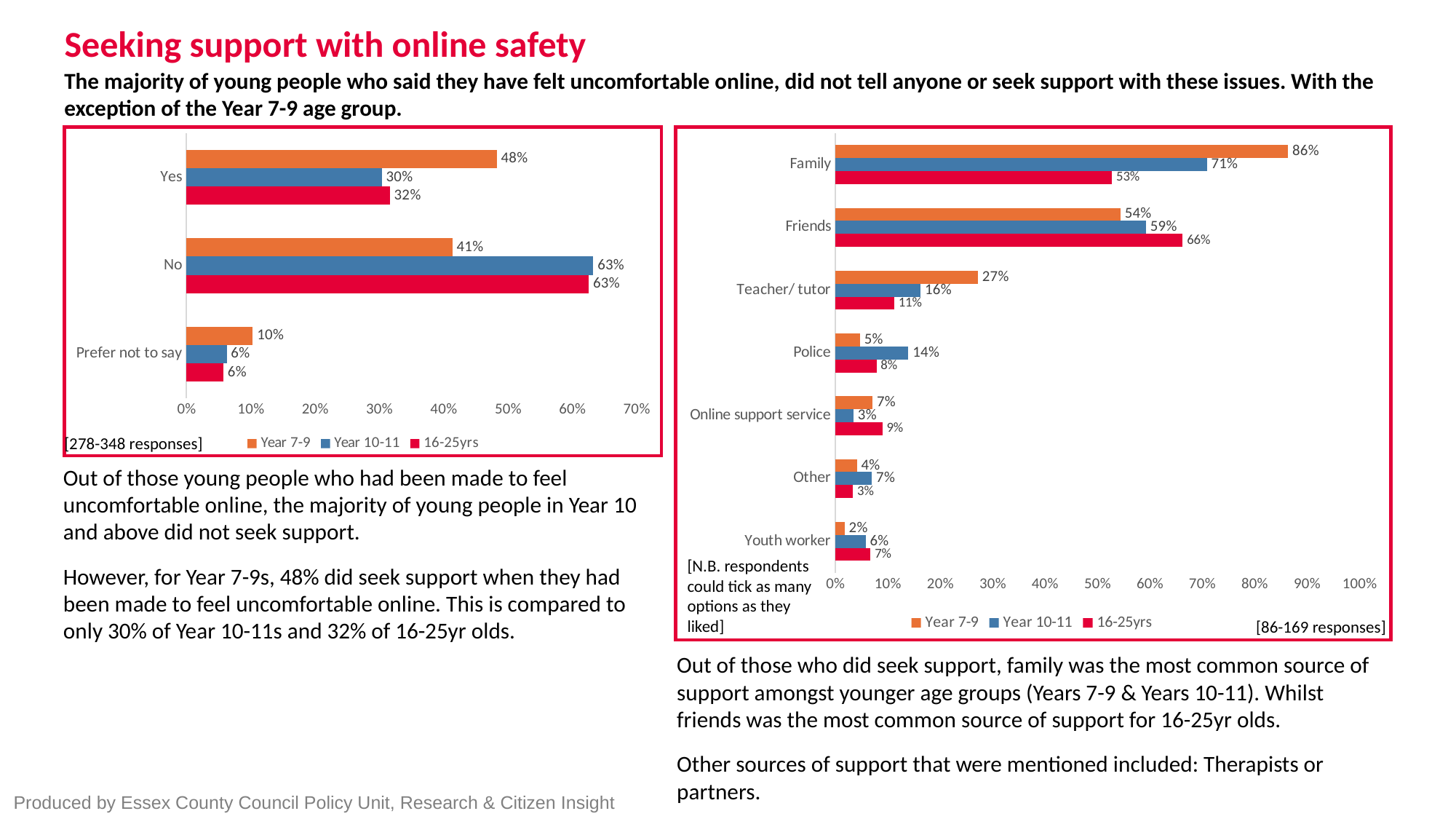
In the right chart, what percentage of 16-25yrs respondents sought support from Friends? 66% In the left chart, what percentage of Year 7-9 respondents answered Yes? 48% In the left chart, what percentage of 16-25yrs respondents answered No? 63% In the left chart, what is the difference between the Year 10-11 and Year 7-9 values for No? 22% In the right chart, what percentage of Year 7-9 respondents sought support from Family? 86% In the left chart, what kind of chart is shown? Bar chart In the right chart, which source of support has the lowest value for Year 7-9? Youth worker In the right chart, how many sources of support are listed on the category axis? 7 In the right chart, what is the difference between the Year 7-9 and 16-25yrs values for Teacher/ tutor? 16% In the left chart, how many series does the legend list? 3 In the right chart, which is larger for Police: the Year 10-11 value or the 16-25yrs value? Year 10-11 In the left chart, which age group has the highest value for Yes? Year 7-9